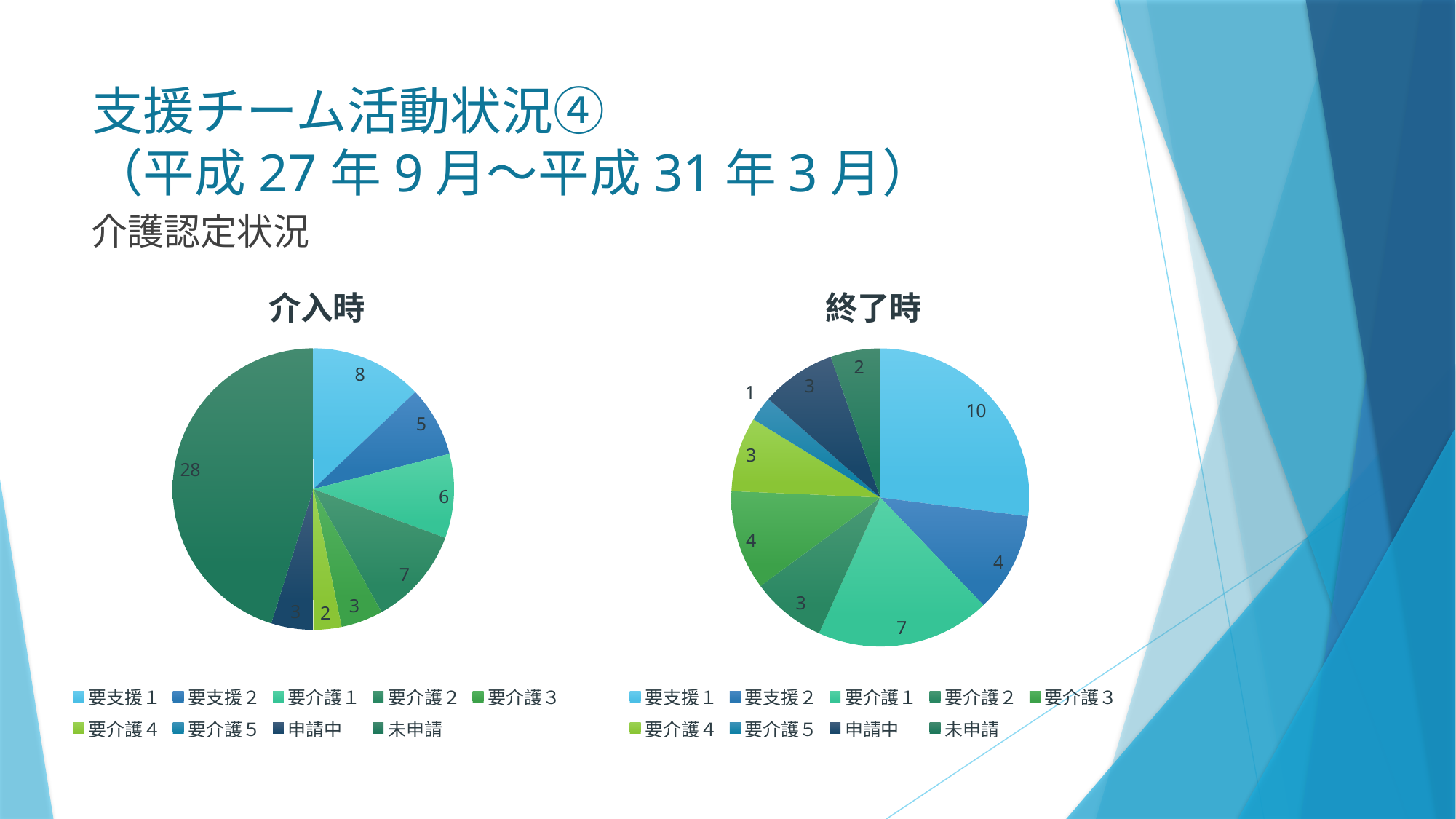
In the 終了時 pie chart, which category has the smallest slice? 要介護5 What type of chart is the 介入時 chart? pie chart What is the difference between the 未申請 value in the 介入時 chart and the 未申請 value in the 終了時 chart? 26 In the 終了時 pie chart, which category has the largest slice? 要支援1 In the 介入時 pie chart, what is the value for 要支援1? 8 How many entries does the legend of the 終了時 pie chart list? 9 In the 終了時 pie chart, what is the value for 要介護1? 7 In the 介入時 pie chart, what is the value for 未申請? 28 In the 介入時 pie chart, which category has the largest slice? 未申請 What is the title of the chart on the right side of the slide? 終了時 In the 介入時 pie chart, which is larger: 要支援2 or 要介護1? 要介護1 In the 終了時 pie chart, what is the value for 要支援1? 10